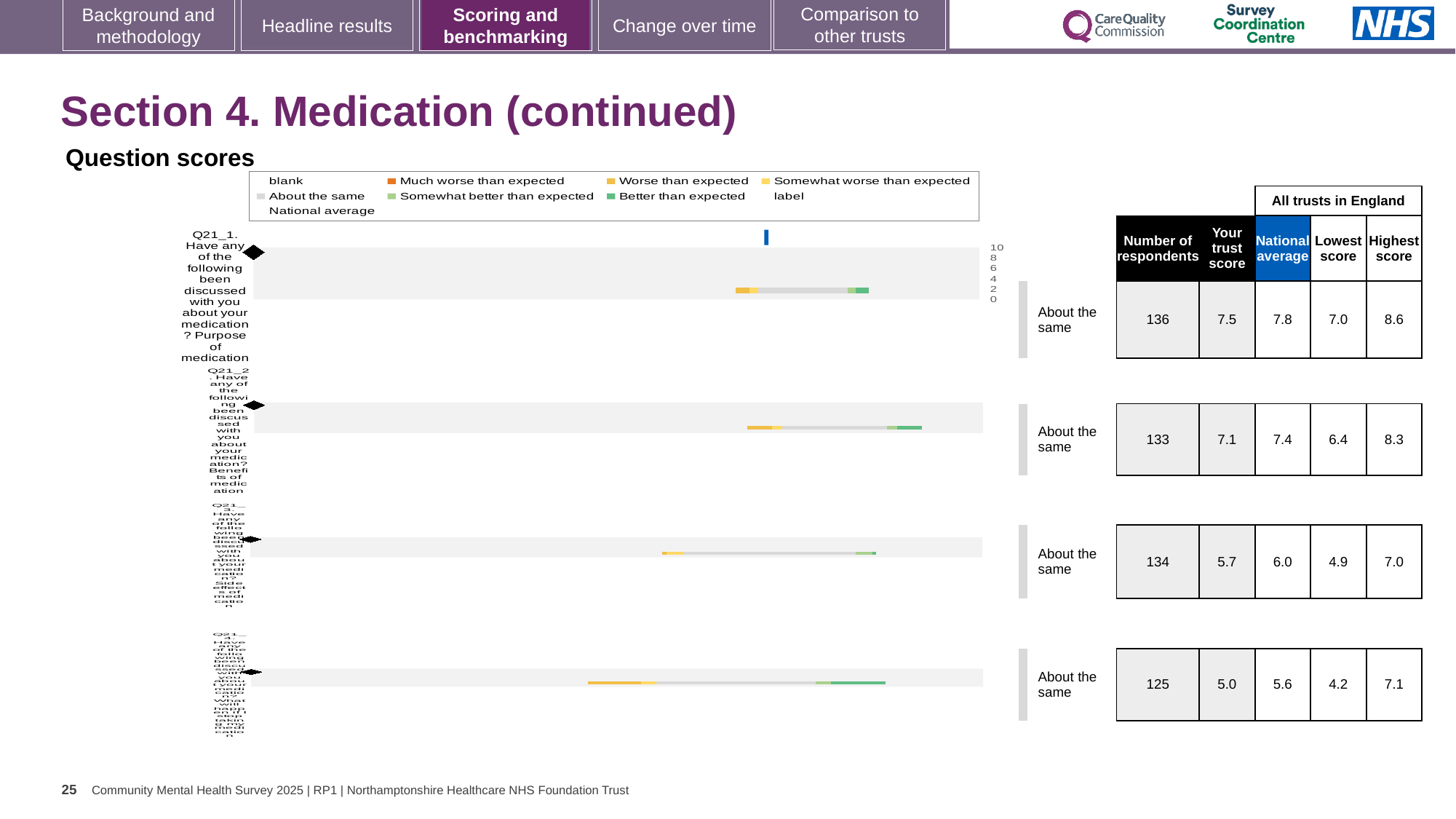
Which question has the lowest 'Your trust score' on this slide? Q21_4 (What might happen if I stop taking medication) What is the highest score across all trusts in England for Q21_4 (What might happen if I stop taking medication)? 7.1 What is the lowest score across all trusts in England for Q21_3 (Side effects of medication)? 4.9 What benchmark category is shown for Q21_1 (Purpose of medication)? About the same What is the 'Your trust score' for Q21_1 (Purpose of medication)? 7.5 What is the difference between the national average and the trust score for Q21_3 (Side effects of medication)? 0.3 What is the national average score for Q21_1 (Purpose of medication)? 7.8 What kind of chart is used to show the question scores? Bar chart How many questions are charted on this slide? 4 Which question has the highest 'Your trust score' on this slide? Q21_1 (Purpose of medication) For Q21_2 (Benefits of medication), which is larger: the trust score or the national average? National average How many respondents answered Q21_2 (Benefits of medication)? 133